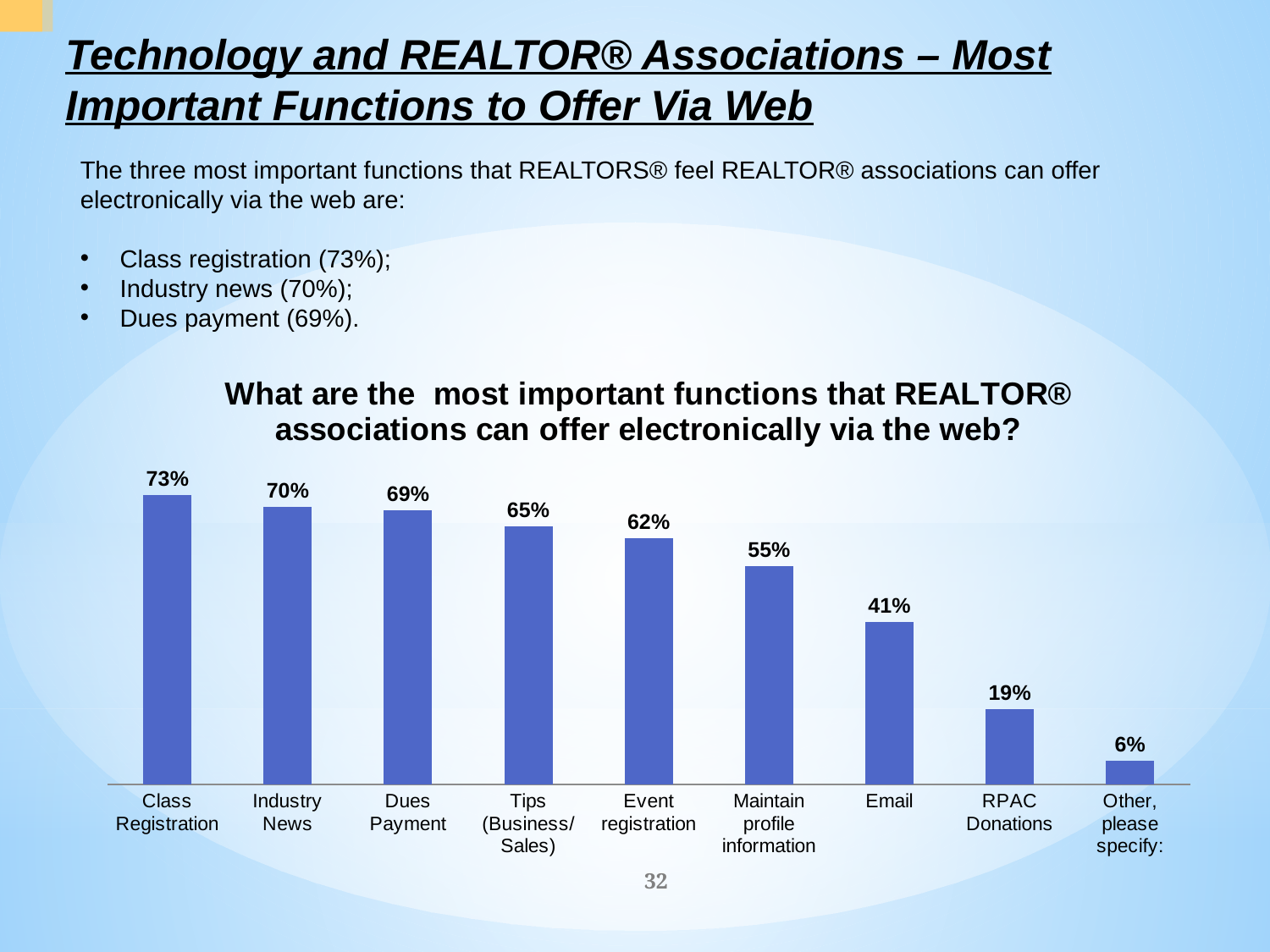
What is the difference between the values for Industry News and Maintain profile information? 15% Do the values rise or fall moving from left to right along the x axis? Fall Which is larger, the value for Tips (Business/Sales) or the value for Dues Payment? Dues Payment What is the value shown for RPAC Donations? 19% What is the value shown for Email? 41% How many categories are shown in the chart? 9 Which category has the highest value in the chart? Class Registration Which category has the lowest value in the chart? Other, please specify: What percentage of respondents chose Class Registration as an important function? 73% What kind of chart is shown on the slide? Bar chart What is the title of the chart? What are the most important functions that REALTOR® associations can offer electronically via the web? What is the difference between the values for Event registration and Email? 21%